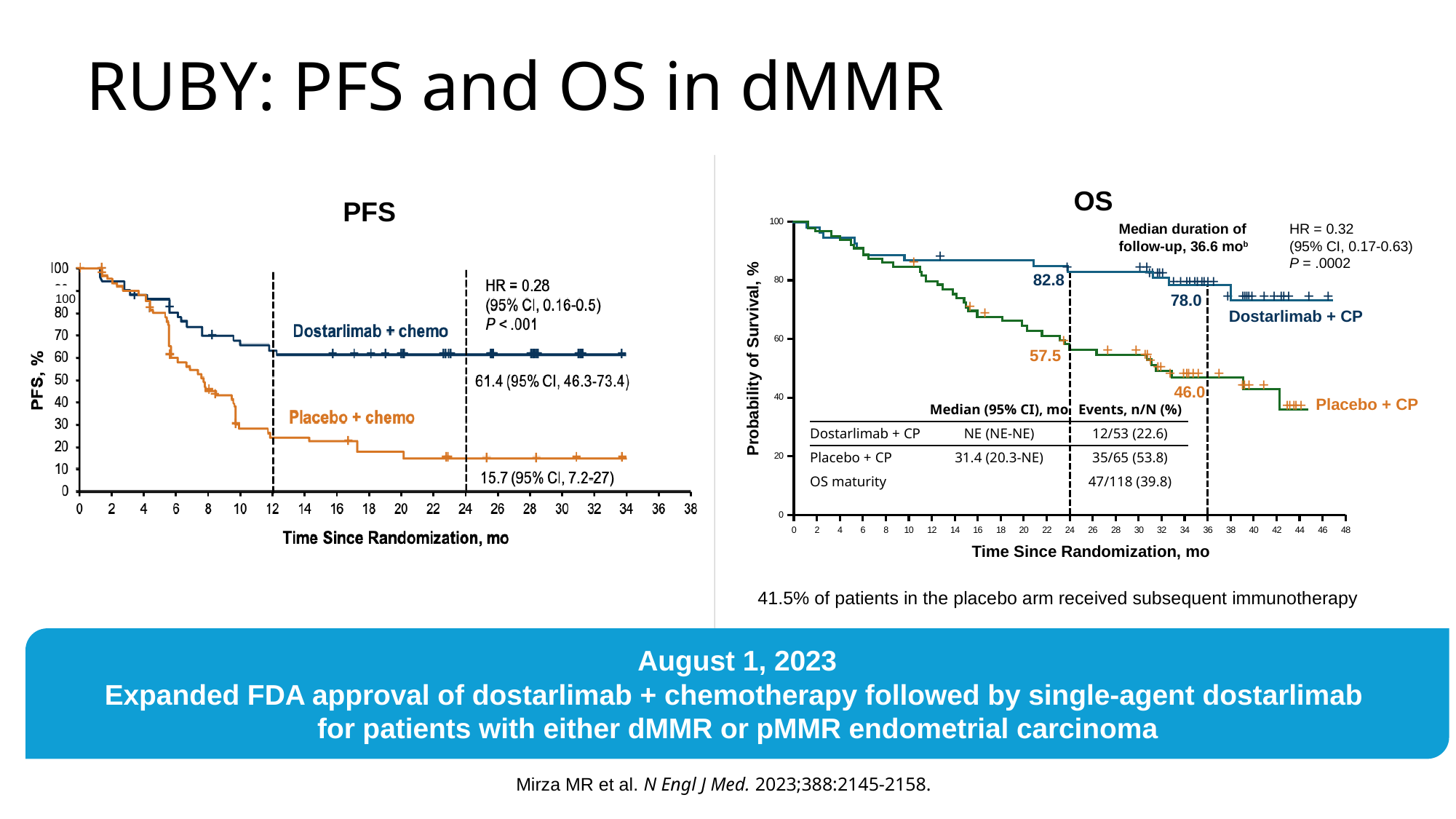
In the PFS chart, what is the hazard ratio shown? HR = 0.28 In the OS chart, what is the 24-month probability of survival for Dostarlimab + CP? 82.8 In the OS chart, how many events (n/N) are reported for Dostarlimab + CP? 12/53 (22.6) What kind of chart is the OS chart? Line chart (Kaplan-Meier survival curve) How many treatment arms are plotted in the PFS chart? 2 In the OS chart, what is the 36-month probability of survival for Placebo + CP? 46.0 In the PFS chart, what is the 24-month PFS rate for Dostarlimab + chemo? 61.4 In the OS chart, what is the difference between the 36-month survival values for Dostarlimab + CP (78.0) and Placebo + CP (46.0)? 32.0 In the PFS chart, what is the difference between the 24-month PFS rates of Dostarlimab + chemo (61.4) and Placebo + chemo (15.7)? 45.7 In the OS chart, what is the median OS (95% CI) for Placebo + CP? 31.4 (20.3-NE) In the OS chart, which arm has the higher probability of survival at 24 months, Dostarlimab + CP or Placebo + CP? Dostarlimab + CP In the PFS chart, what is the 24-month PFS rate for Placebo + chemo? 15.7